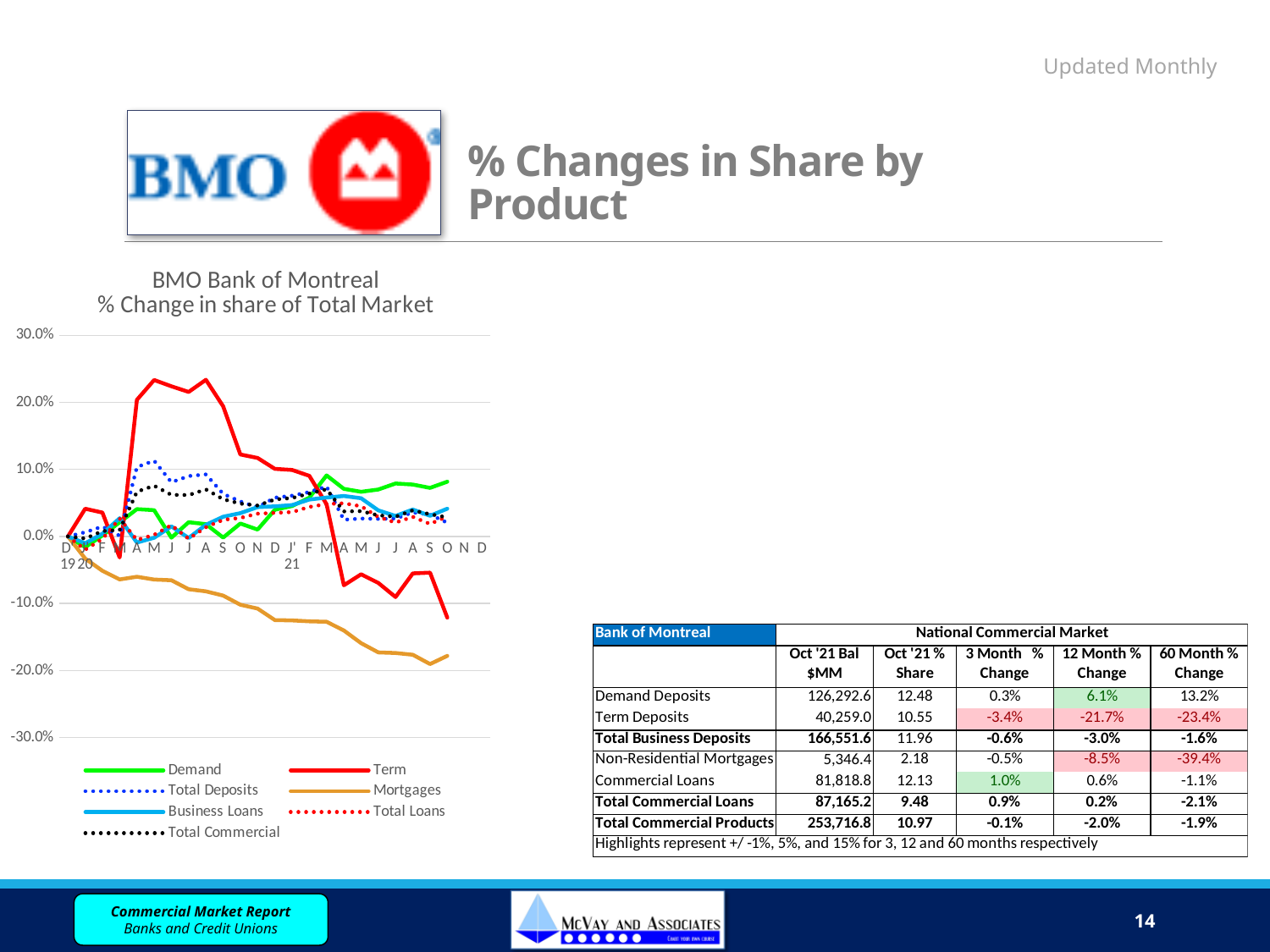
Which series has the lowest value at the end of the chart (D 21)? Mortgages What kind of chart is shown on the slide? line chart How many series does the chart legend list? 7 Is the peak value for Term in 2020 greater or less than 20.0%? greater Is the value for Mortgages at the end of the chart greater or less than -10.0%? less Which series reaches the highest value on the chart? Term Does the Mortgages series generally rise or fall along the x axis? fall At the end of the chart, which is larger: the value for Demand or the value for Mortgages? Demand Is the value for Demand at the end of the chart greater or less than 0.0%? greater What is the title of the chart? BMO Bank of Montreal % Change in share of Total Market What colour is the Term line in the chart? red